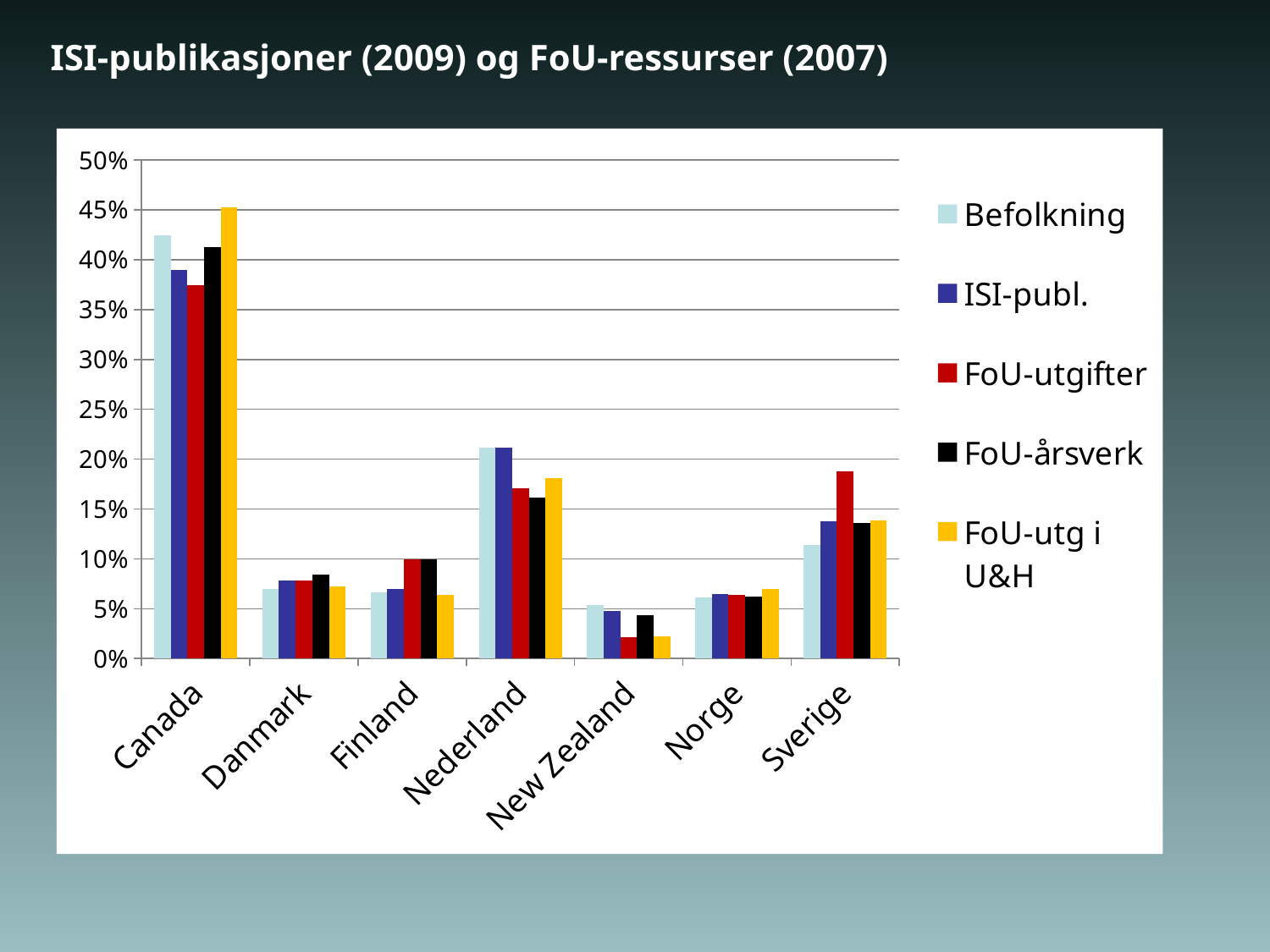
How many series does the legend of the chart list? 5 What is the title of the slide containing the chart? ISI-publikasjoner (2009) og FoU-ressurser (2007) Which country has the highest Befolkning value in the chart? Canada For Canada, which is larger: Befolkning or FoU-utgifter? Befolkning Is the Befolkning value for Nederland greater or less than 15%? greater Which country has the lowest FoU-utgifter value in the chart? New Zealand Is the FoU-utg i U&H value for Canada greater or less than 40%? greater Is the FoU-utgifter value for New Zealand greater or less than 5%? less What colour represents the FoU-årsverk series in the chart? black What kind of chart is shown on the slide? bar chart How many countries are shown on the x axis of the chart? 7 For Sverige, which is larger: FoU-utgifter or Befolkning? FoU-utgifter